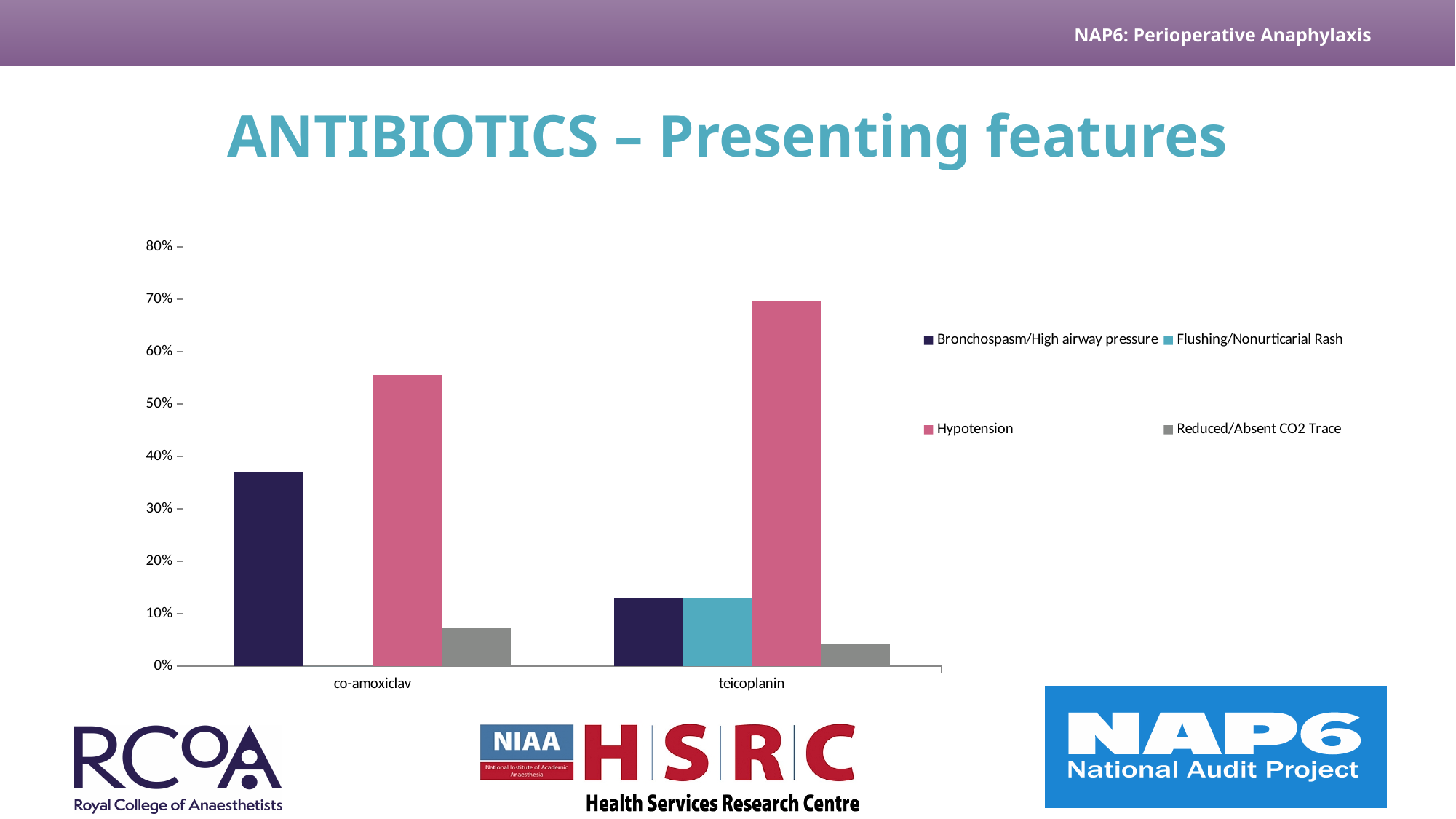
Which antibiotic has the larger Bronchospasm/High airway pressure value, co-amoxiclav or teicoplanin? co-amoxiclav Is the Bronchospasm/High airway pressure value for co-amoxiclav greater or less than 30%? greater Which presenting feature has the highest value for co-amoxiclav? Hypotension How many series does the legend list? 4 Which presenting feature has the highest value for teicoplanin? Hypotension What colour represents Hypotension in the chart? pink What kind of chart is shown on the slide? bar chart Which presenting feature has the lowest value for teicoplanin? Reduced/Absent CO2 Trace Is the Reduced/Absent CO2 Trace value for co-amoxiclav greater or less than 10%? less Is the Hypotension value for teicoplanin greater or less than 60%? greater Which antibiotic has the larger Hypotension value, co-amoxiclav or teicoplanin? teicoplanin How many antibiotic categories are shown on the x axis? 2